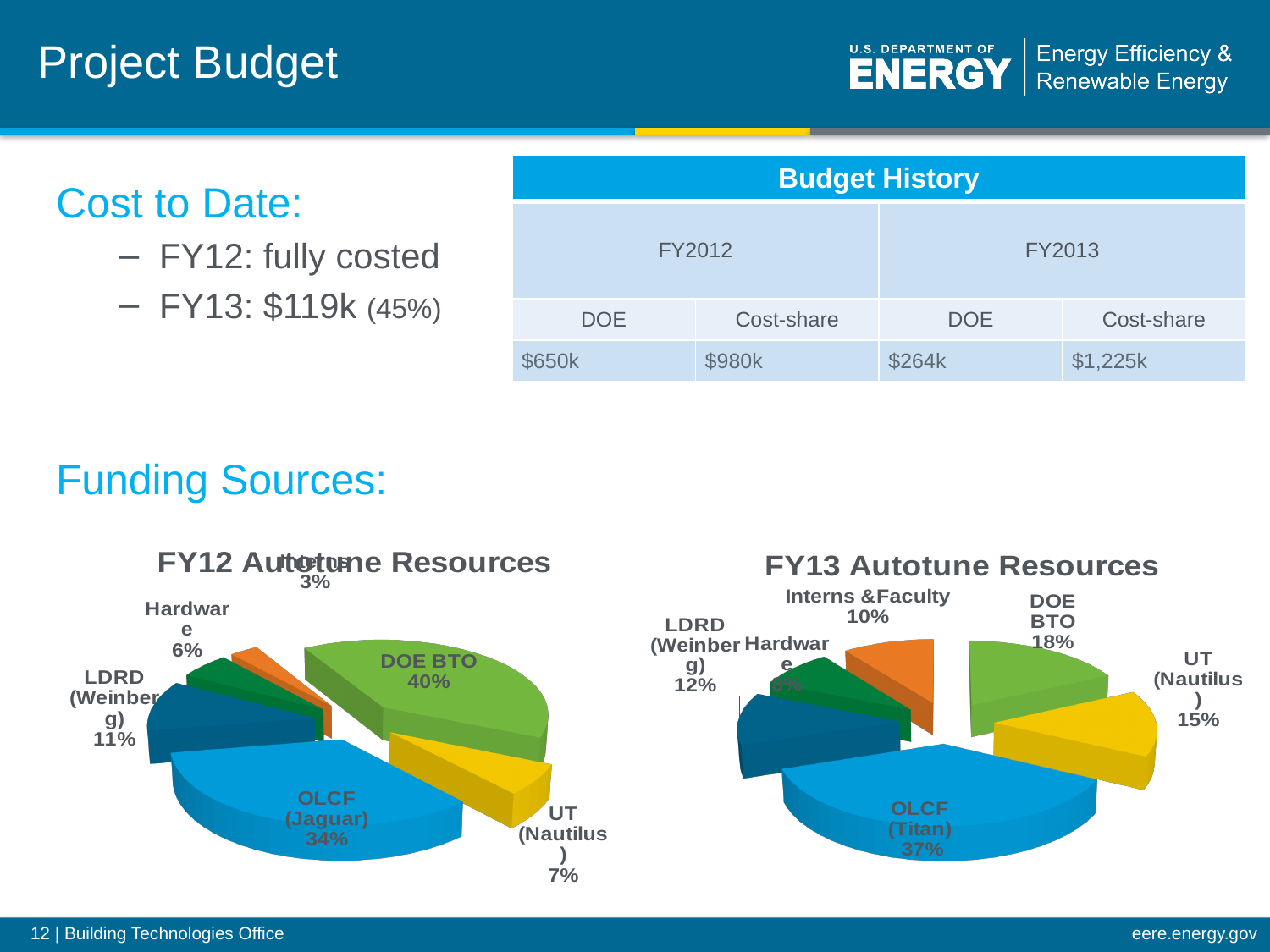
In the FY12 Autotune Resources chart, what share does OLCF (Jaguar) have? 34% In the FY13 Autotune Resources chart, what share does OLCF (Titan) have? 37% What kind of chart is the FY13 Autotune Resources chart? Pie chart In the FY13 Autotune Resources chart, which is larger, the share for Interns & Faculty or the share for LDRD (Weinberg)? LDRD (Weinberg) In the FY12 Autotune Resources chart, what share does UT (Nautilus) have? 7% In the FY13 Autotune Resources chart, which category has the largest share? OLCF (Titan) In the FY12 Autotune Resources chart, which category has the largest share? DOE BTO In the FY12 Autotune Resources chart, what is the difference between the DOE BTO share and the OLCF (Jaguar) share? 6%